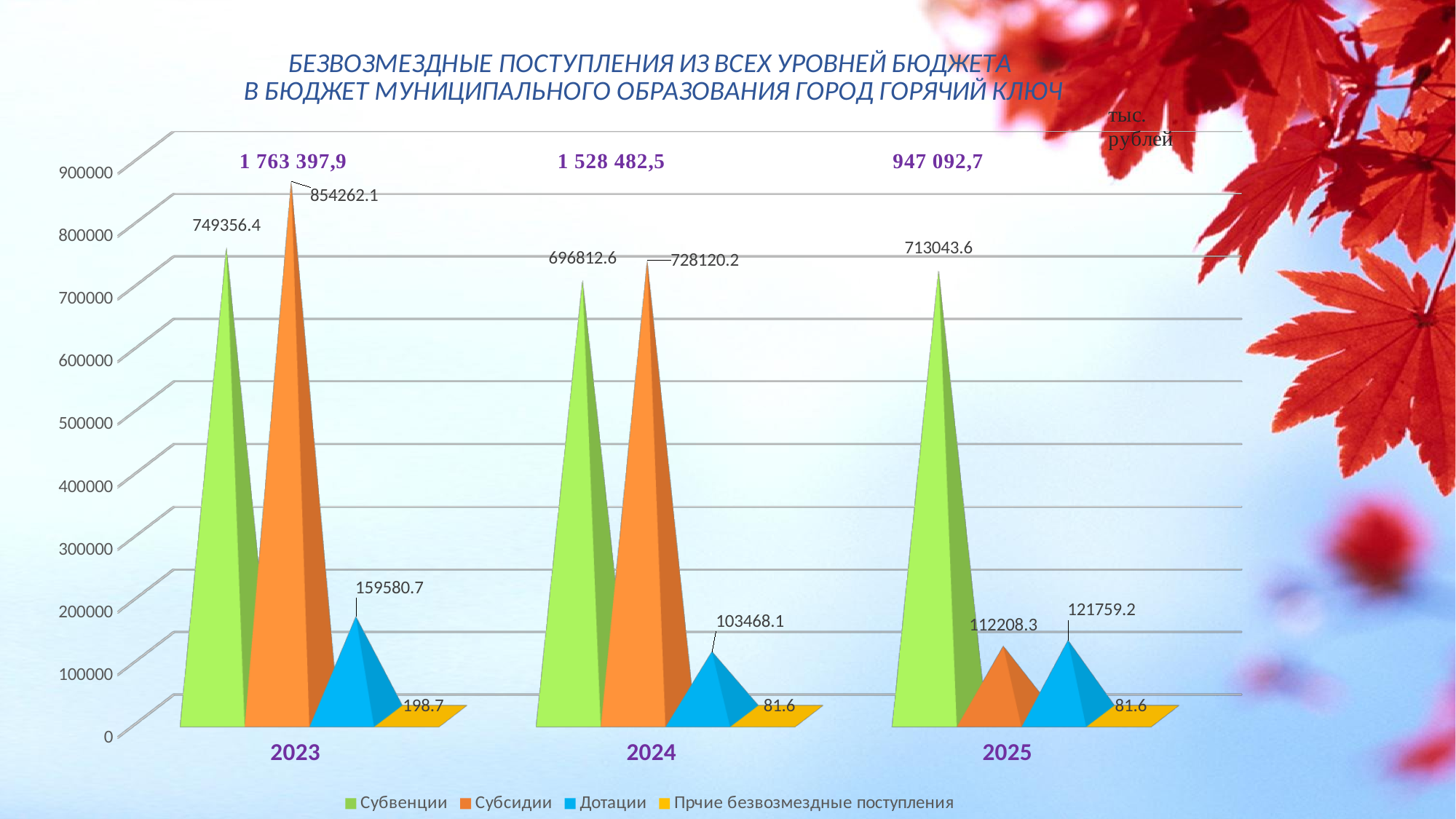
What is the total shown above the 2024 group? 1 528 482,5 What is the difference between Субсидии and Субвенции in 2023? 104905.7 What is the value for Дотации in 2025? 121759.2 Is the value for Субсидии in 2025 greater or less than 200000? less What is the value for Прчие безвозмездные поступления in 2023? 198.7 Which year has the lowest value for Дотации? 2024 What is the value for Субвенции in 2023? 749356.4 Which year has the highest value for Субсидии? 2023 What is the value for Субсидии in 2024? 728120.2 How many series does the legend list? 4 Which is larger in 2025: Субвенции or Субсидии? Субвенции How many years are shown on the x axis? 3